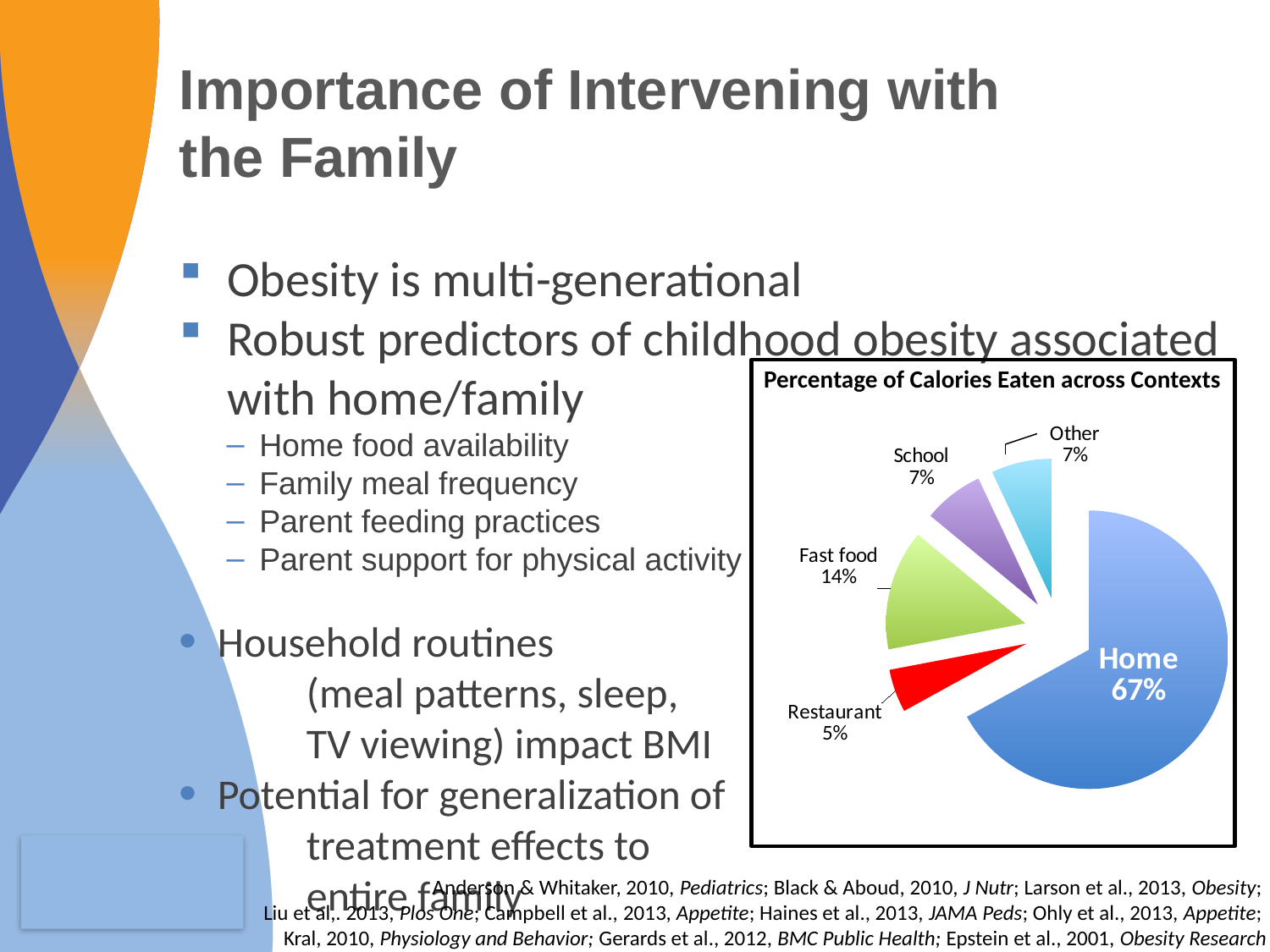
What percentage of calories is eaten at Fast food? 14% Which is larger, the share for Fast food or the share for School? Fast food What type of chart is shown on the slide? Pie chart Which context accounts for the largest share of calories? Home Which context accounts for the smallest share of calories? Restaurant What is the difference between the Home and Fast food percentages? 53% What is the combined share of School and Other? 14% How many slices does the pie chart have? 5 What percentage of calories is eaten at Restaurant? 5% What percentage of calories is eaten at Home? 67% What is the title of the chart? Percentage of Calories Eaten across Contexts What percentage of calories is eaten at School? 7%